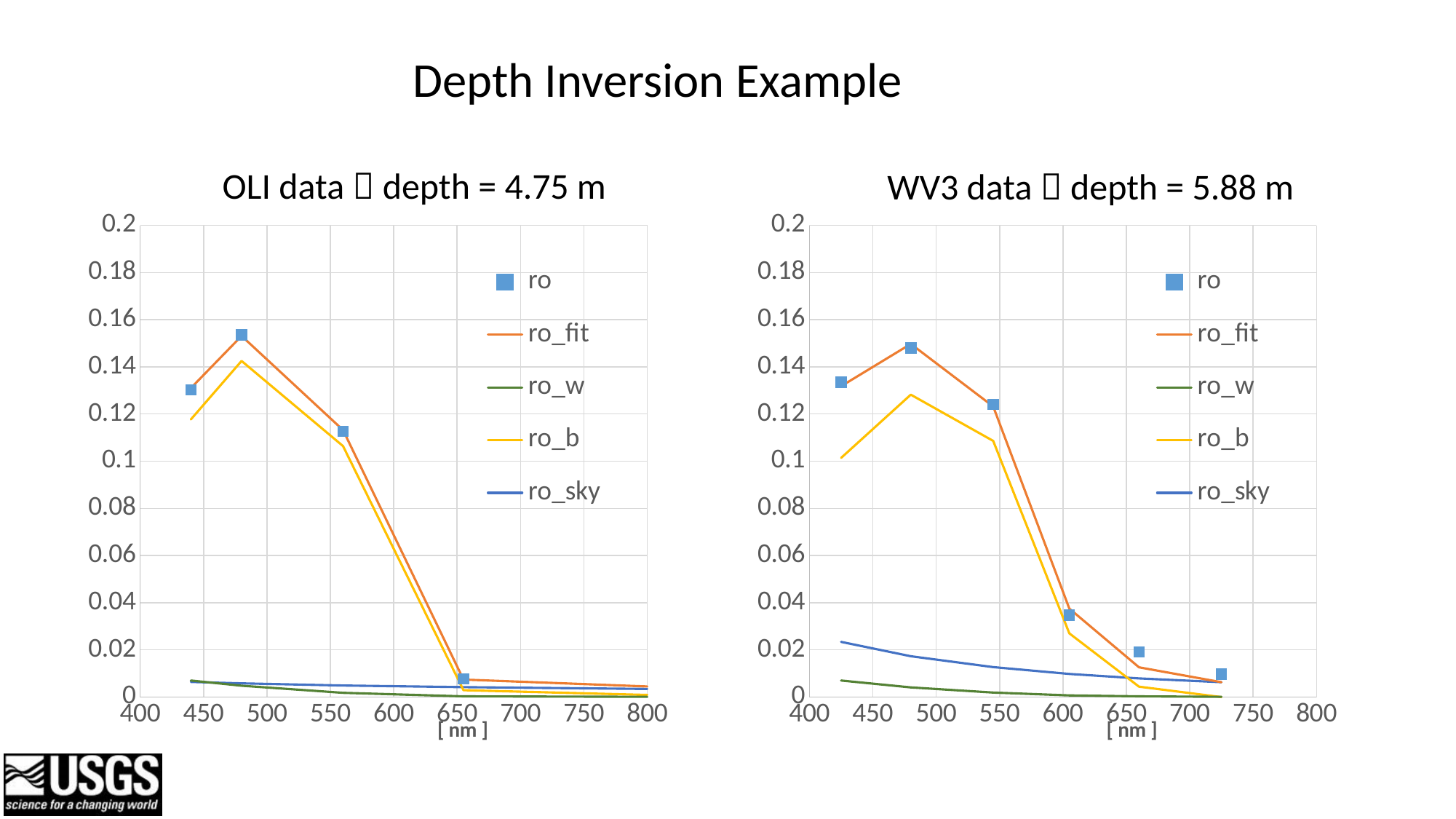
On the left chart (OLI data), how many ro data points are plotted? 4 On the right chart (WV3 data), is the ro value at about 425 nm greater or less than 0.12? greater What depth is given in the title of the right chart? 5.88 m On the left chart (OLI data), how many series does the legend list? 5 On the left chart (OLI data), at about 480 nm, which is higher: ro_fit or ro_b? ro_fit On the right chart (WV3 data), how many ro data points are plotted? 6 On the right chart (WV3 data), does the ro_sky line rise or fall as wavelength increases? fall What kind of chart is the right chart (WV3 data)? line chart On the left chart (OLI data), which series is drawn in yellow? ro_b On the left chart (OLI data), is the ro value at about 480 nm greater or less than 0.14? greater On the right chart (WV3 data), is the ro value at about 660 nm greater or less than 0.04? less